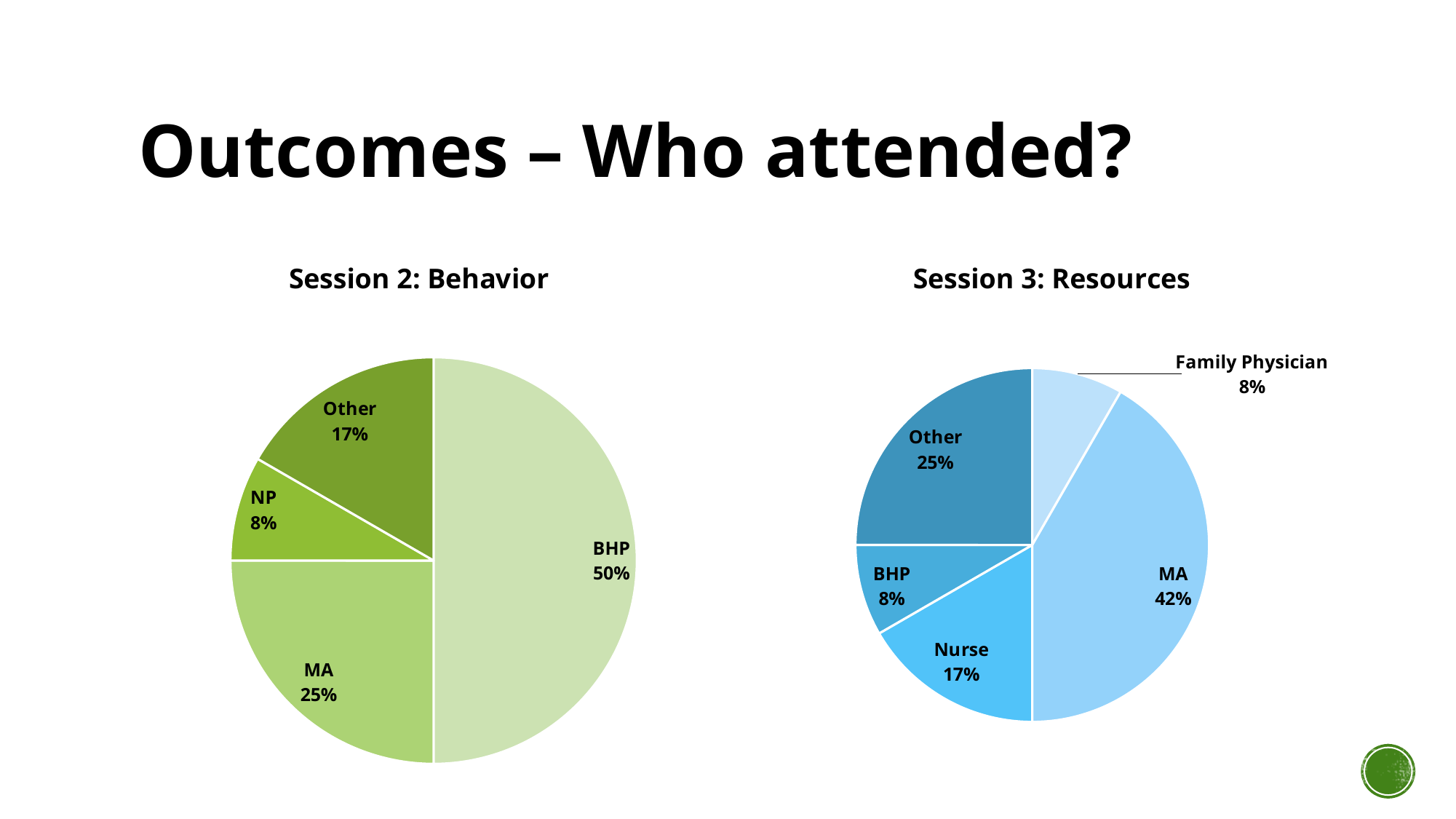
In the 'Session 2: Behavior' chart, which category has the smallest slice? NP In the 'Session 3: Resources' chart, which category has the largest slice? MA In the 'Session 3: Resources' chart, which is larger, Other or Nurse? Other In the 'Session 2: Behavior' chart, how many categories are shown? 4 In the 'Session 3: Resources' chart, what share of attendees were Nurse? 17% In the 'Session 3: Resources' chart, what share of attendees were MA? 42% In the 'Session 3: Resources' chart, how many categories are shown? 5 In the 'Session 2: Behavior' chart, what share of attendees were BHP? 50% In the 'Session 2: Behavior' chart, which category has the largest slice? BHP In the 'Session 2: Behavior' chart, what is the difference in percentage points between BHP and Other? 33 What type of chart is used for 'Session 3: Resources'? Pie chart In the 'Session 2: Behavior' chart, what share of attendees were MA? 25%